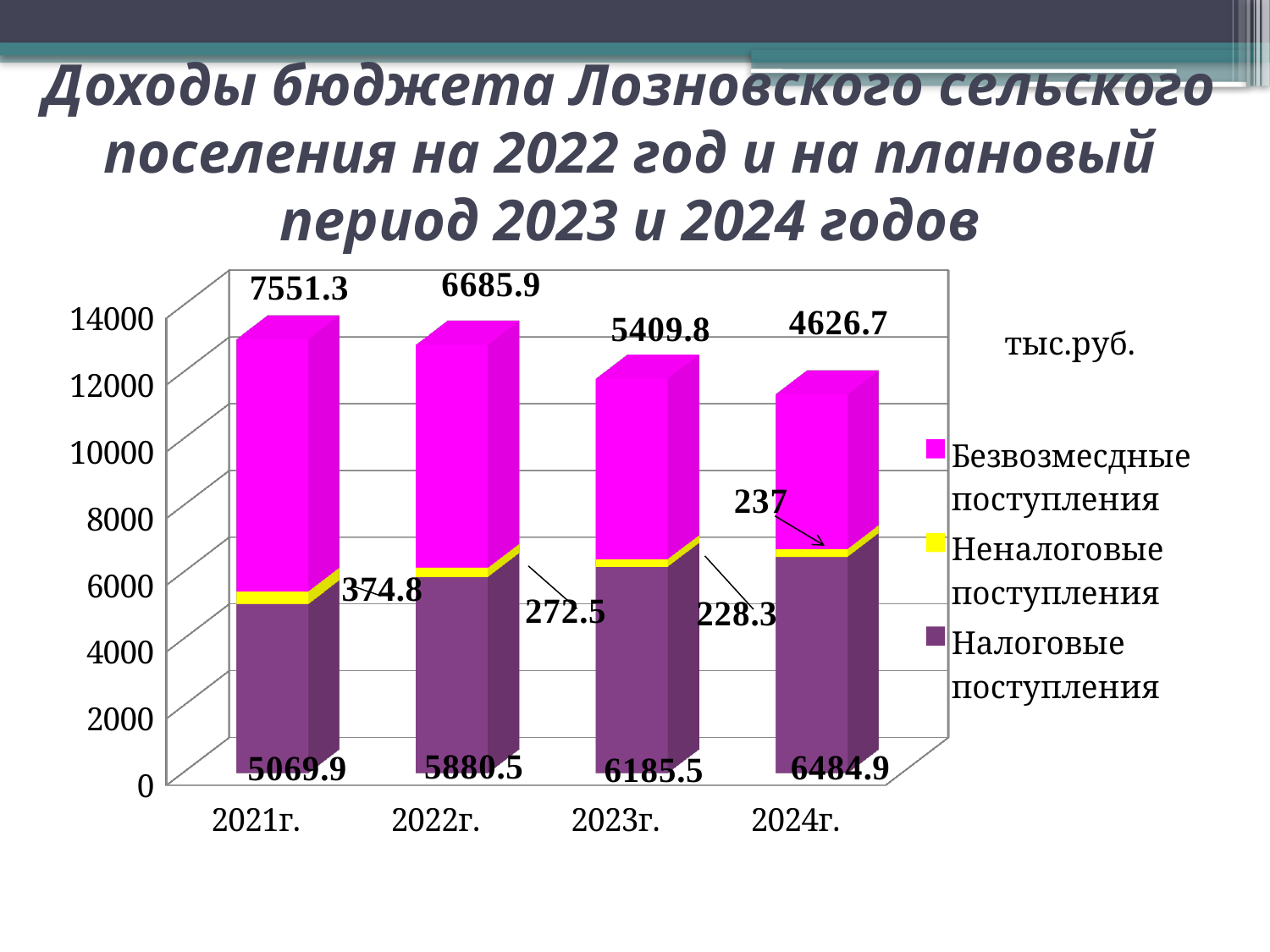
In which year is Безвозмездные поступления highest? 2021г. What is the value of Безвозмездные поступления for 2024г.? 4626.7 What is the value of Неналоговые поступления for 2023г.? 228.3 How many series does the legend list? 3 What kind of chart is shown on the slide? Stacked bar chart What is the total of the stacked bar for 2023г.? 11823.6 What is the difference between Налоговые поступления in 2024г. and 2021г.? 1415 Do the values of Безвозмездные поступления rise or fall from 2021г. to 2024г.? Fall How many years are shown on the x axis? 4 In which year is Налоговые поступления lowest? 2021г. Which is larger in 2022г.: Налоговые поступления or Безвозмездные поступления? Безвозмездные поступления What is the value of Налоговые поступления for 2021г.? 5069.9